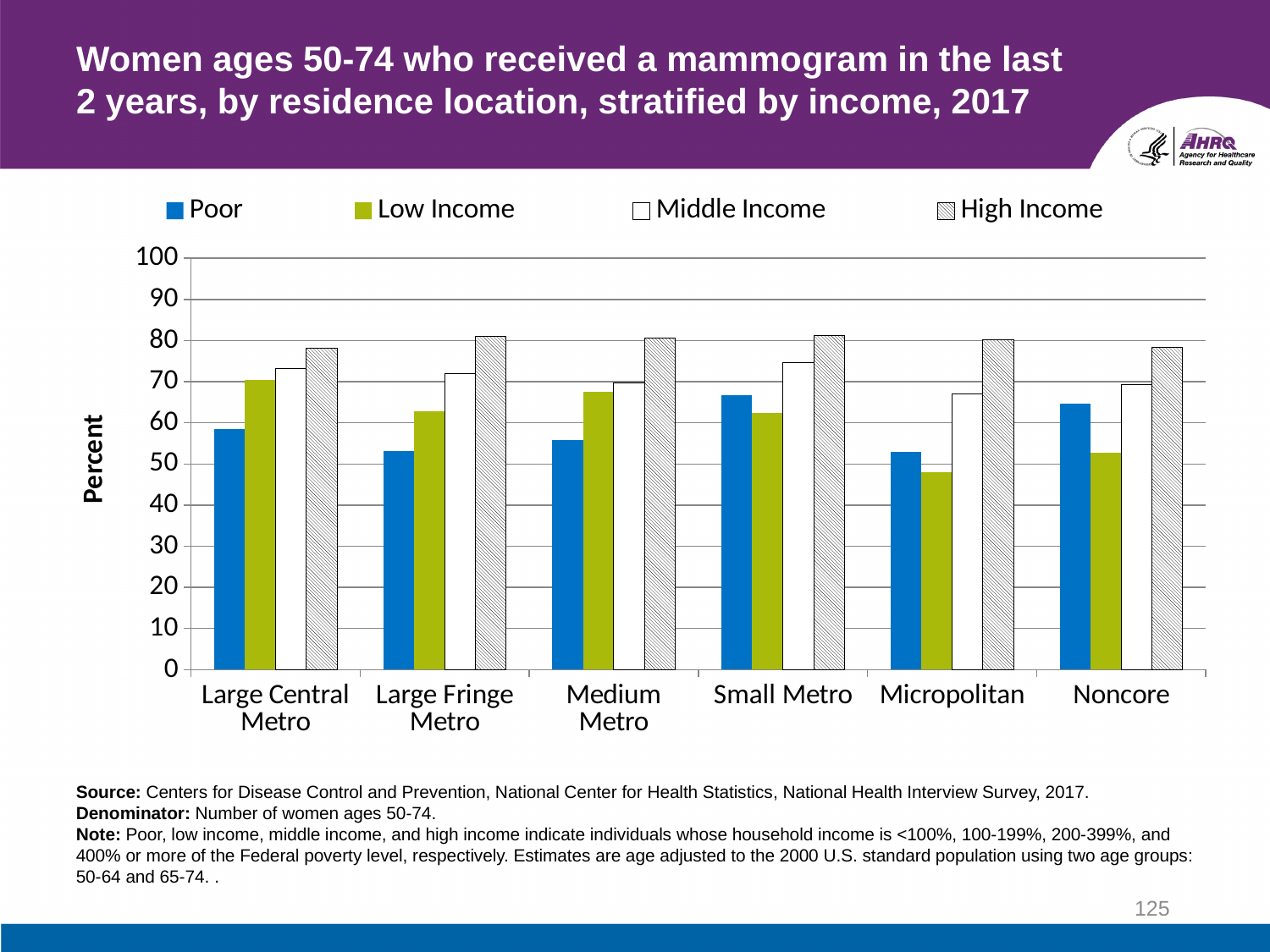
Is the value for Low Income in Micropolitan greater or less than 60? less How many residence location categories are shown on the x axis? 6 Is the value for High Income in Large Fringe Metro greater or less than 70? greater In Small Metro, which is larger: the Poor value or the Low Income value? Poor What is the label on the y axis? Percent What kind of chart is shown on the slide? Bar chart Which residence location has the lowest Low Income value? Micropolitan In Micropolitan, which income group has the highest value? High Income In Noncore, which is larger: the Poor value or the Low Income value? Poor How many income series does the legend list? 4 Is the value for Poor in Large Fringe Metro greater or less than 60? less